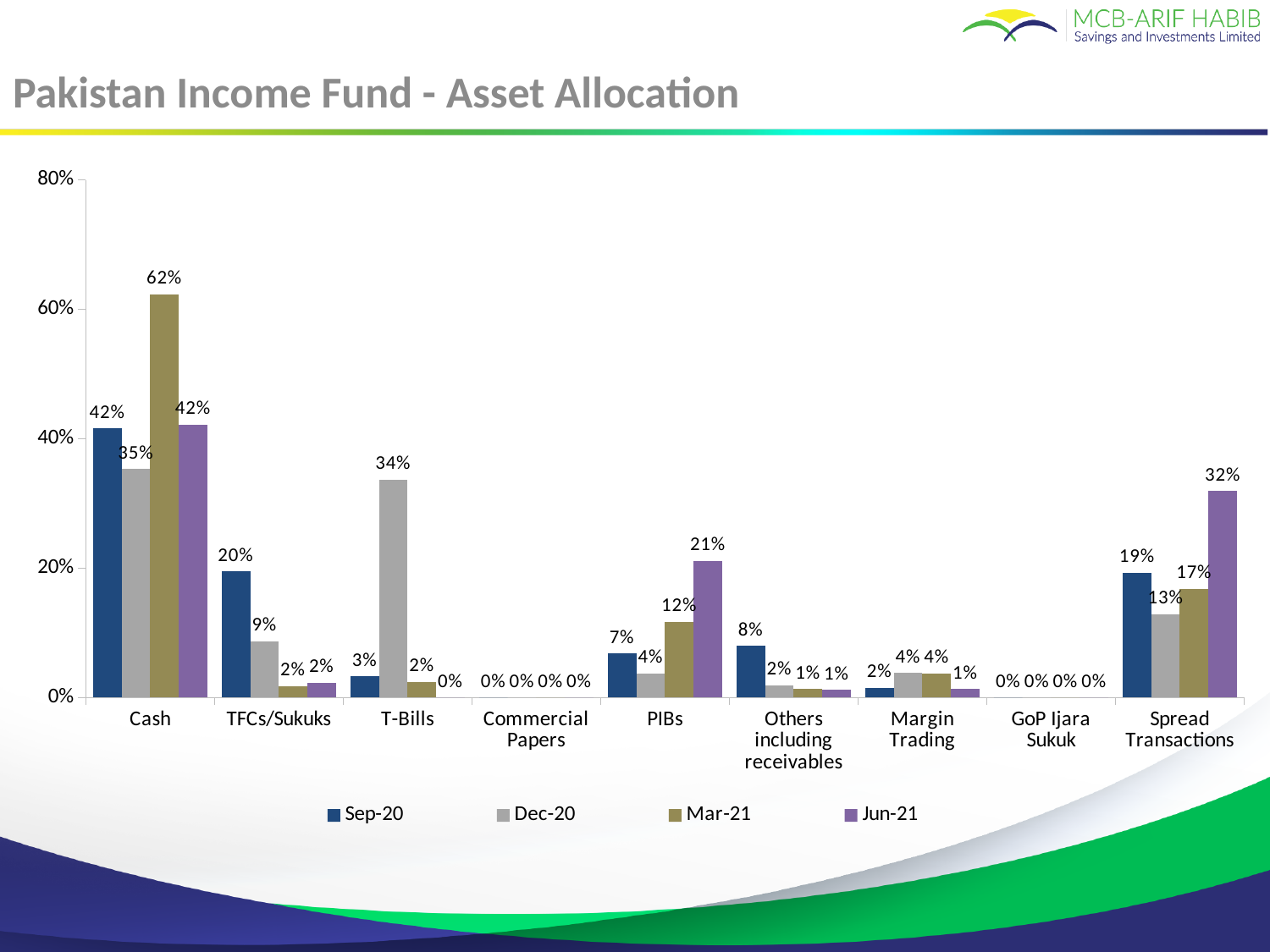
What is the Dec-20 value for T-Bills? 34% What kind of chart is shown on the slide? Bar chart What is the Mar-21 value for Cash? 62% Which category has the highest Jun-21 value? Cash Which is larger for PIBs: the Jun-21 value or the Mar-21 value? Jun-21 What is the title of the slide? Pakistan Income Fund - Asset Allocation What is the difference between the Mar-21 and Sep-20 values for Cash? 20% How many series does the legend list? 4 Which series has the lowest value for Cash? Dec-20 What is the Sep-20 value for TFCs/Sukuks? 20% How many categories are shown on the x axis? 9 What is the Jun-21 value for Spread Transactions? 32%